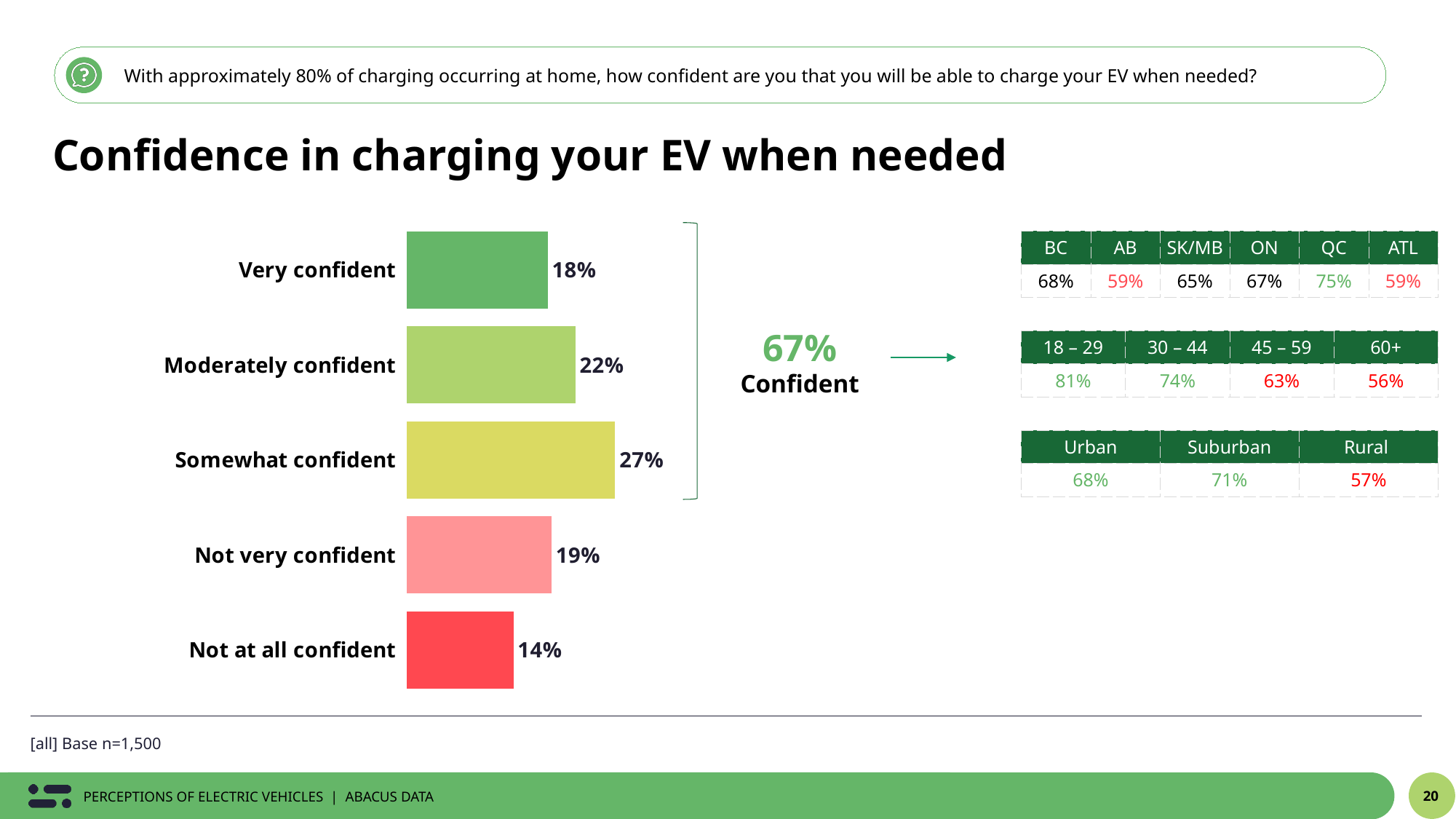
What is the title of the chart? Confidence in charging your EV when needed What is the combined percentage of the three confident categories (very, moderately, somewhat)? 67% What colour is the bar for 'Not at all confident'? Red How many confidence categories are shown in the bar chart? 5 Which confidence category has the lowest percentage? Not at all confident Which confidence category has the highest percentage? Somewhat confident What kind of chart is used to show the confidence levels? Bar chart What is the difference between 'Moderately confident' and 'Very confident'? 4 percentage points Which is larger, 'Not very confident' or 'Very confident'? Not very confident What is the value for 'Somewhat confident'? 27% What is the value for 'Not at all confident'? 14% What percentage of respondents are very confident they will be able to charge their EV when needed? 18%